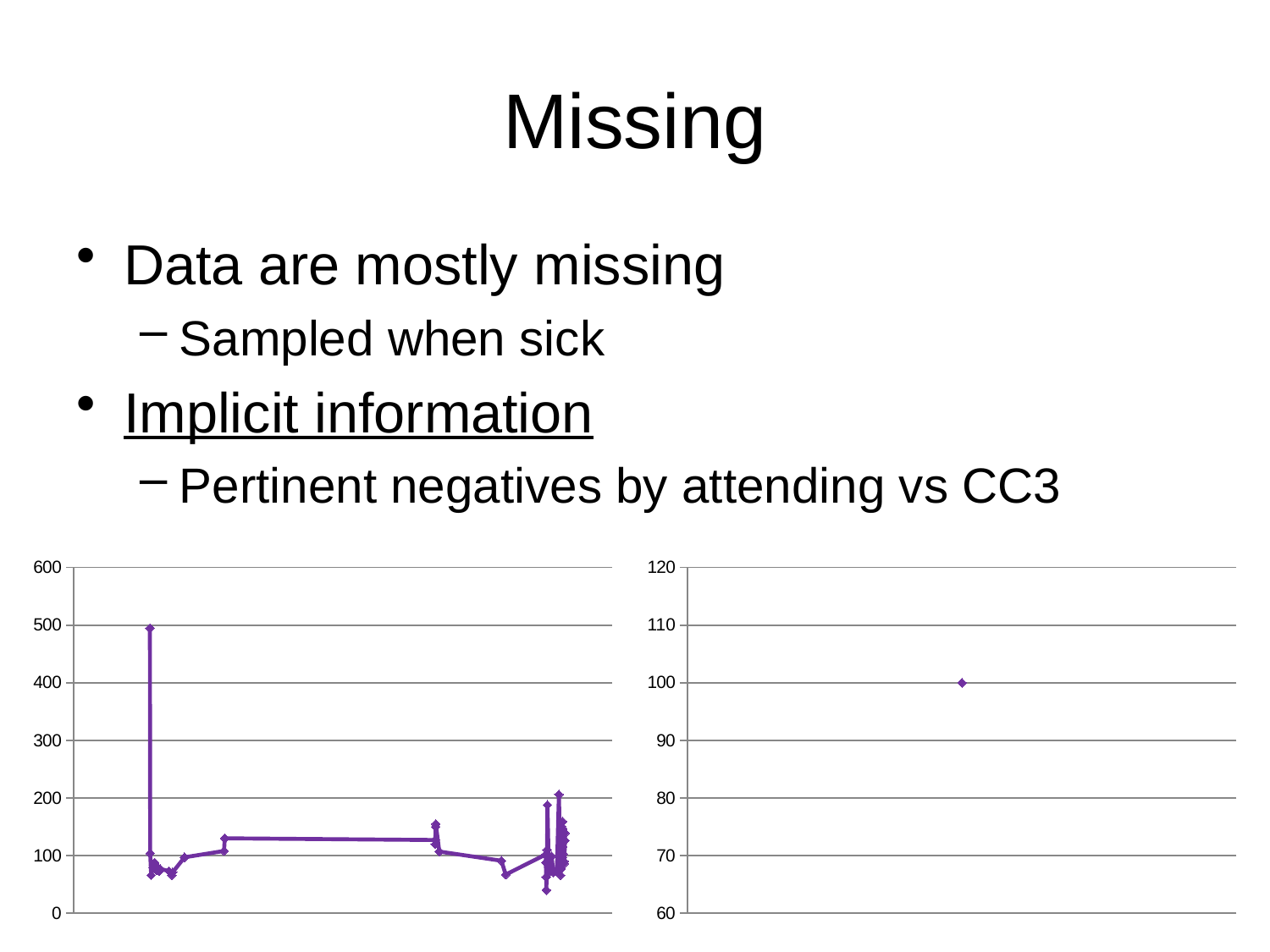
In the chart on the left of the slide, is the highest plotted value greater or less than 400? greater In the chart on the right of the slide, is the value of the plotted point greater or less than 110? less In the chart on the left of the slide, what is the maximum value shown on the y-axis? 600 In the chart on the right of the slide, is the value of the plotted point greater or less than 90? greater How many charts are shown on the slide? 2 What kind of chart is the chart on the left of the slide? line chart